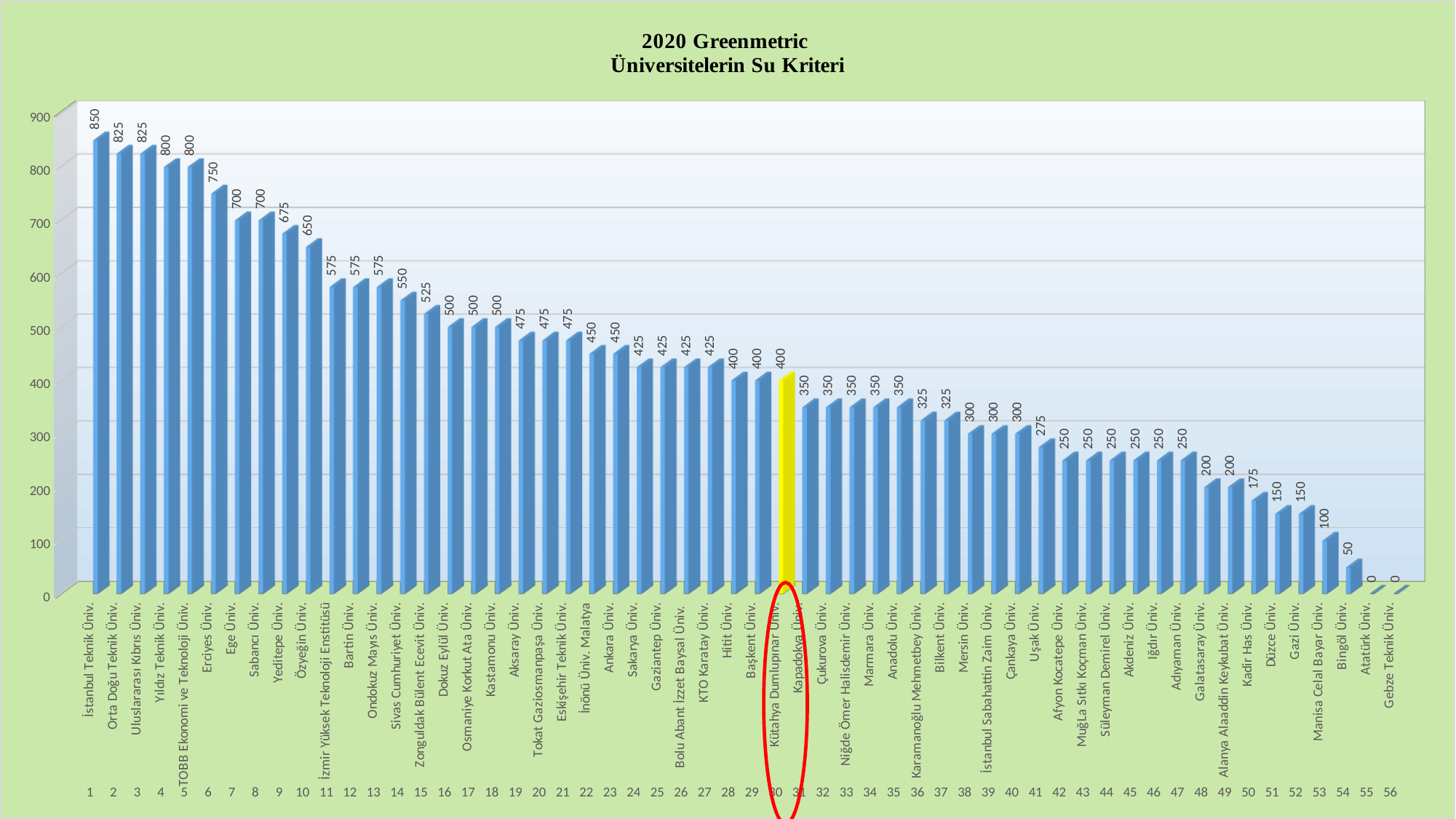
What is the difference between the values for Yeditepe Üniv. and Özyeğin Üniv.? 25 What kind of chart is shown on the slide? Bar chart Which has a larger value, Sivas Cumhuriyet Üniv. or Kapadokya Üniv.? Sivas Cumhuriyet Üniv. What is the value for İstanbul Teknik Üniv.? 850 What is the value for Kütahya Dumlupınar Üniv., the bar highlighted in yellow? 400 How many universities are shown in the chart? 56 Which university has the highest value in the chart? İstanbul Teknik Üniv. What is the title of the chart? 2020 Greenmetric Üniversitelerin Su Kriteri Do the values rise or fall from left to right along the x axis? Fall What is the value for Erciyes Üniv.? 750 What is the value for Bingöl Üniv.? 50 What is the difference between the values for İstanbul Teknik Üniv. and Kütahya Dumlupınar Üniv.? 450